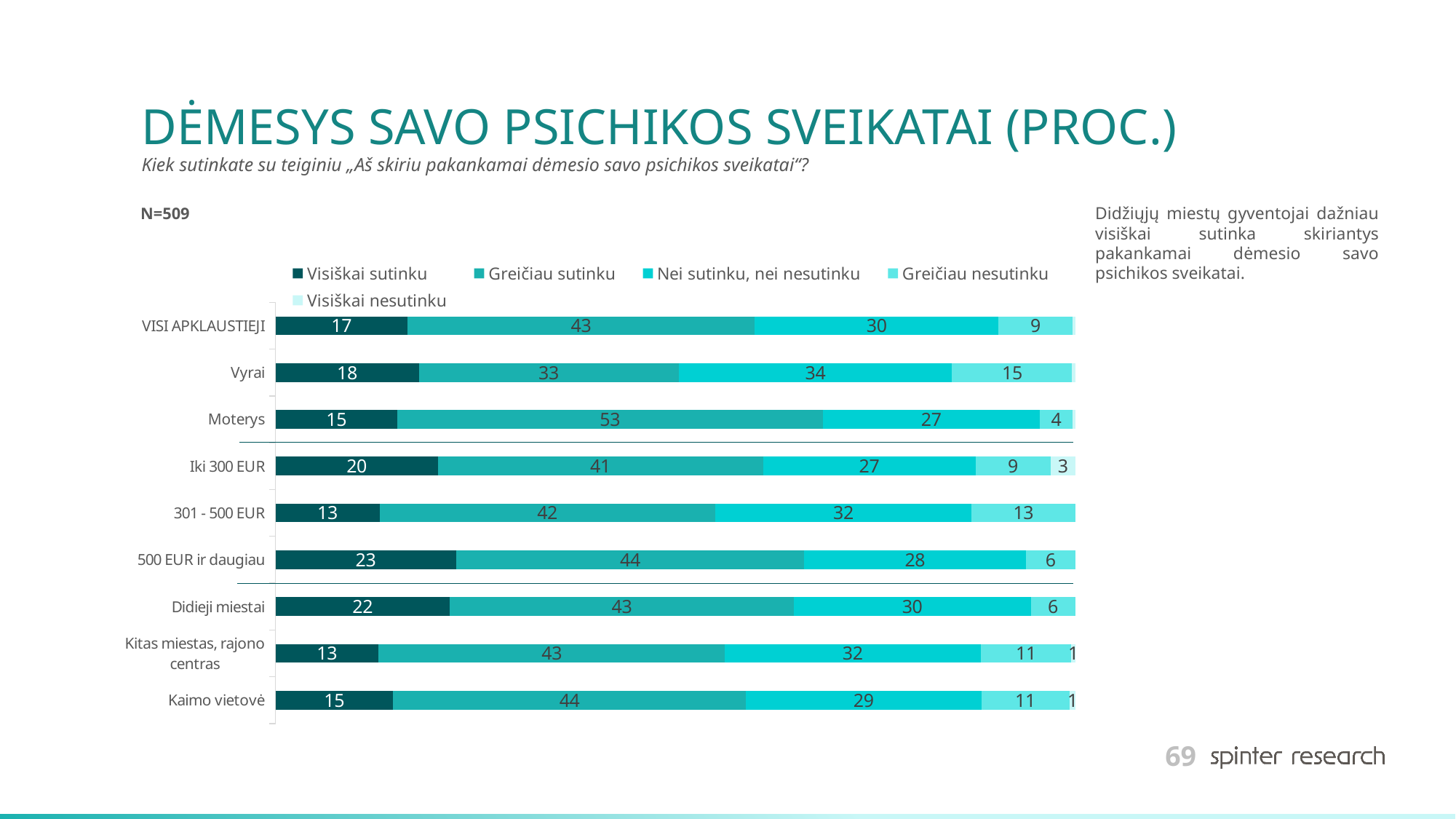
What kind of chart is shown on the slide? Stacked bar chart Which category has the lowest value for "Greičiau sutinku"? Vyrai What is the value of "Greičiau sutinku" for Moterys? 53 Which has a larger "Nei sutinku, nei nesutinku" value, Vyrai or Moterys? Vyrai How many categories are shown on the chart? 9 What is the value of "Visiškai sutinku" for 500 EUR ir daugiau? 23 How many series does the legend list? 5 What is the value of "Greičiau nesutinku" for Vyrai? 15 Which category has the highest value for "Visiškai sutinku"? 500 EUR ir daugiau What is the value of "Visiškai nesutinku" for Iki 300 EUR? 3 What is the total of the stacked bar for Kaimo vietovė? 100 What is the difference between the "Greičiau sutinku" values for Moterys and Vyrai? 20